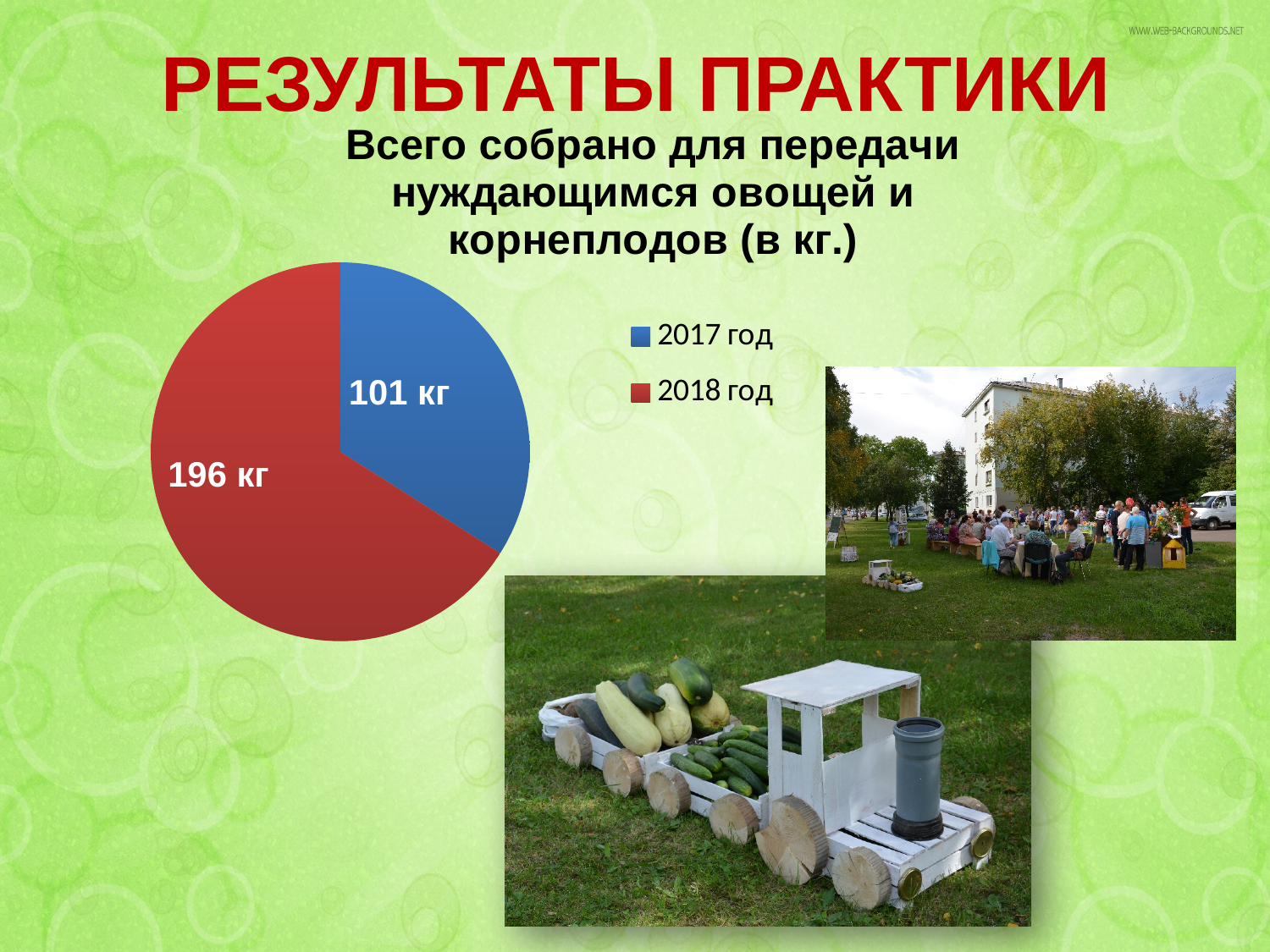
How many slices does the pie chart have? 2 What is the value shown for 2018 год in the pie chart? 196 кг Which colour represents 2017 год in the pie chart? blue What is the value shown for 2017 год in the pie chart? 101 кг Which year has the largest slice in the pie chart? 2018 год How many entries does the legend of the pie chart list? 2 Which is larger in the pie chart, the value for 2017 год or for 2018 год? 2018 год What is the difference between the values for 2018 год and 2017 год in the pie chart? 95 кг What is the total of the two values shown in the pie chart? 297 кг What type of chart is shown on the slide? pie chart Which year has the smallest slice in the pie chart? 2017 год What share of the pie does the 2018 год slice represent, to the nearest whole percent? 66%